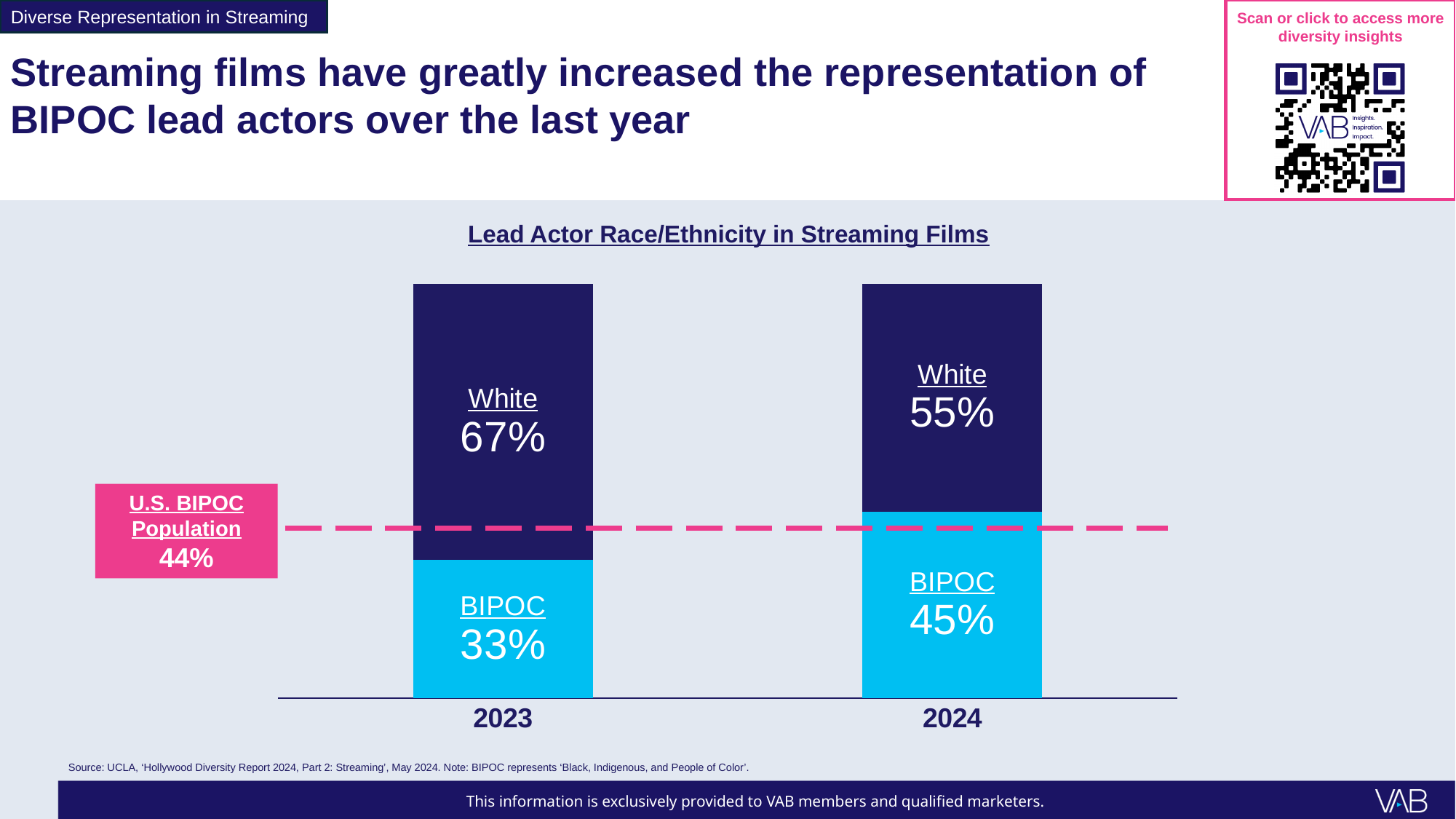
How many years are shown on the x axis of the chart? 2 What kind of chart is shown on the slide? stacked bar chart What is the BIPOC share of lead actors in streaming films in 2024? 45% What is the BIPOC share of lead actors in streaming films in 2023? 33% What is the White share of lead actors in streaming films in 2024? 55% What value does the dashed reference line labelled U.S. BIPOC Population represent? 44% Which year has the higher White share of lead actors, 2023 or 2024? 2023 What is the title of the chart? Lead Actor Race/Ethnicity in Streaming Films What is the total of the stacked bar for 2024? 100% Does the BIPOC share of lead actors rise or fall from 2023 to 2024? rise What is the White share of lead actors in streaming films in 2023? 67% By how many percentage points did the BIPOC share of lead actors increase from 2023 to 2024? 12